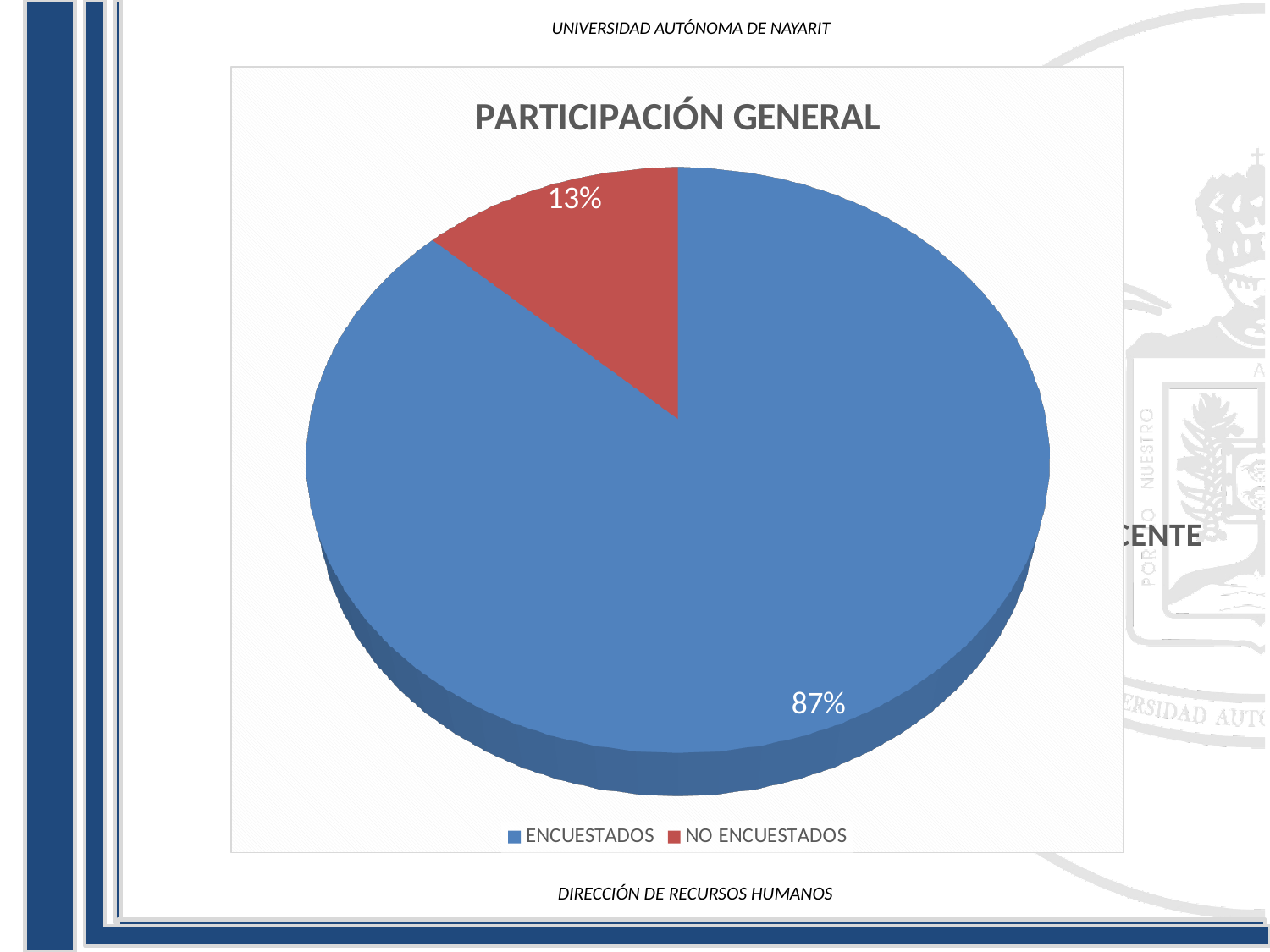
How many slices does the pie chart have? 2 What colour is the NO ENCUESTADOS slice? red What share of the pie does ENCUESTADOS represent? 87% How many entries does the legend list? 2 Which is larger, the share for ENCUESTADOS or the share for NO ENCUESTADOS? ENCUESTADOS What is the title of the chart? PARTICIPACIÓN GENERAL What is the difference in percentage points between ENCUESTADOS and NO ENCUESTADOS? 74 What share of the pie does NO ENCUESTADOS represent? 13% Which category has the largest slice of the pie? ENCUESTADOS Which category has the smallest slice of the pie? NO ENCUESTADOS What kind of chart is shown on the slide? pie chart